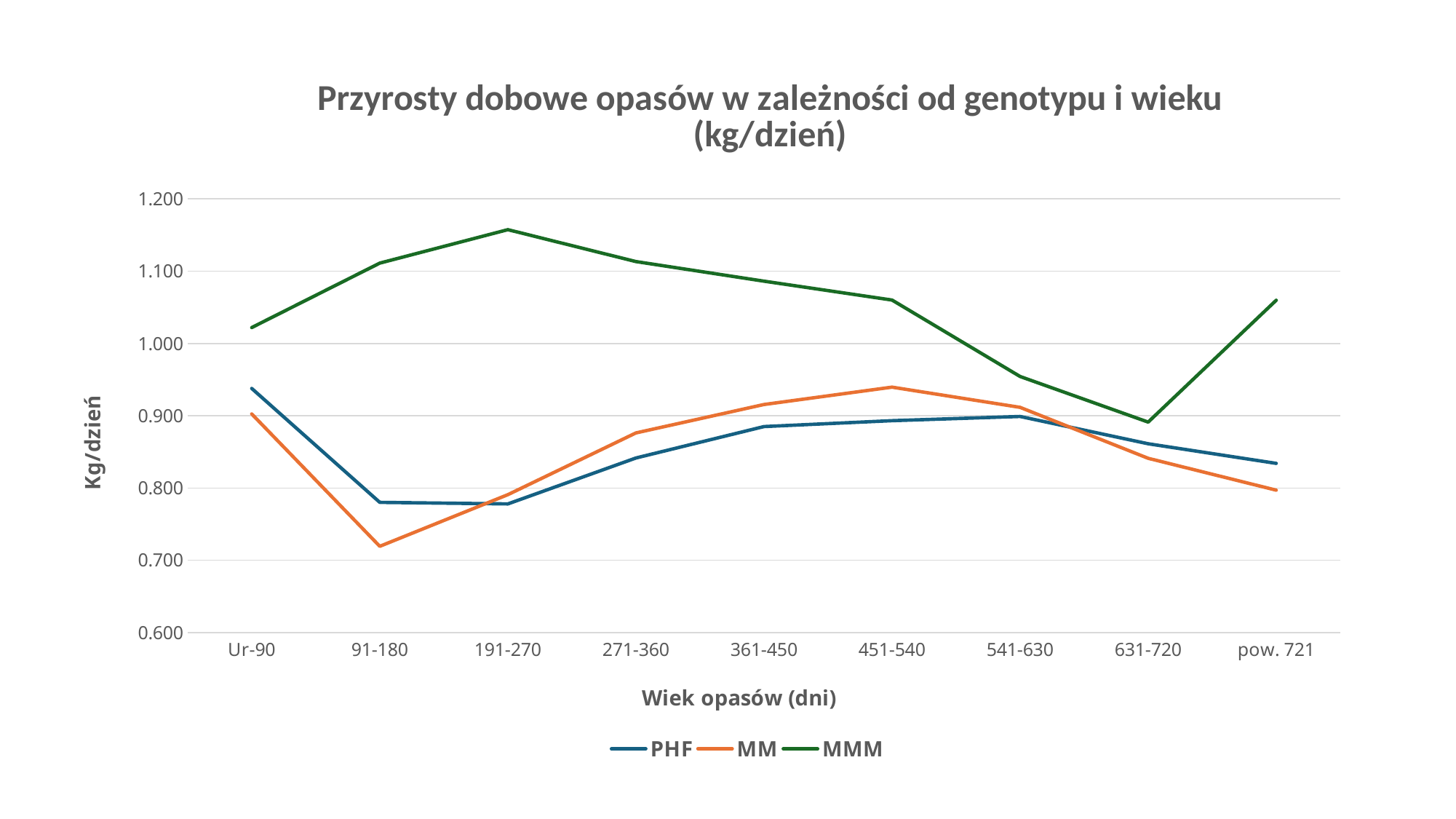
In which age category does the MMM series reach its highest value? 191-270 At 451-540, which series has the higher value, MM or PHF? MM How many series does the legend list? 3 How many age categories are shown on the x axis? 9 Does the MMM series rise or fall from 191-270 to 631-720? fall Is the value for MMM at 191-270 greater or less than 1.100? greater Is the value for MM at 91-180 greater or less than 0.800? less In which age category does the MMM series reach its lowest value? 631-720 In which age category does the MM series reach its lowest value? 91-180 What kind of chart is shown on the slide? line chart At Ur-90, which series has the higher value, PHF or MM? PHF What is the title of the y axis? Kg/dzień